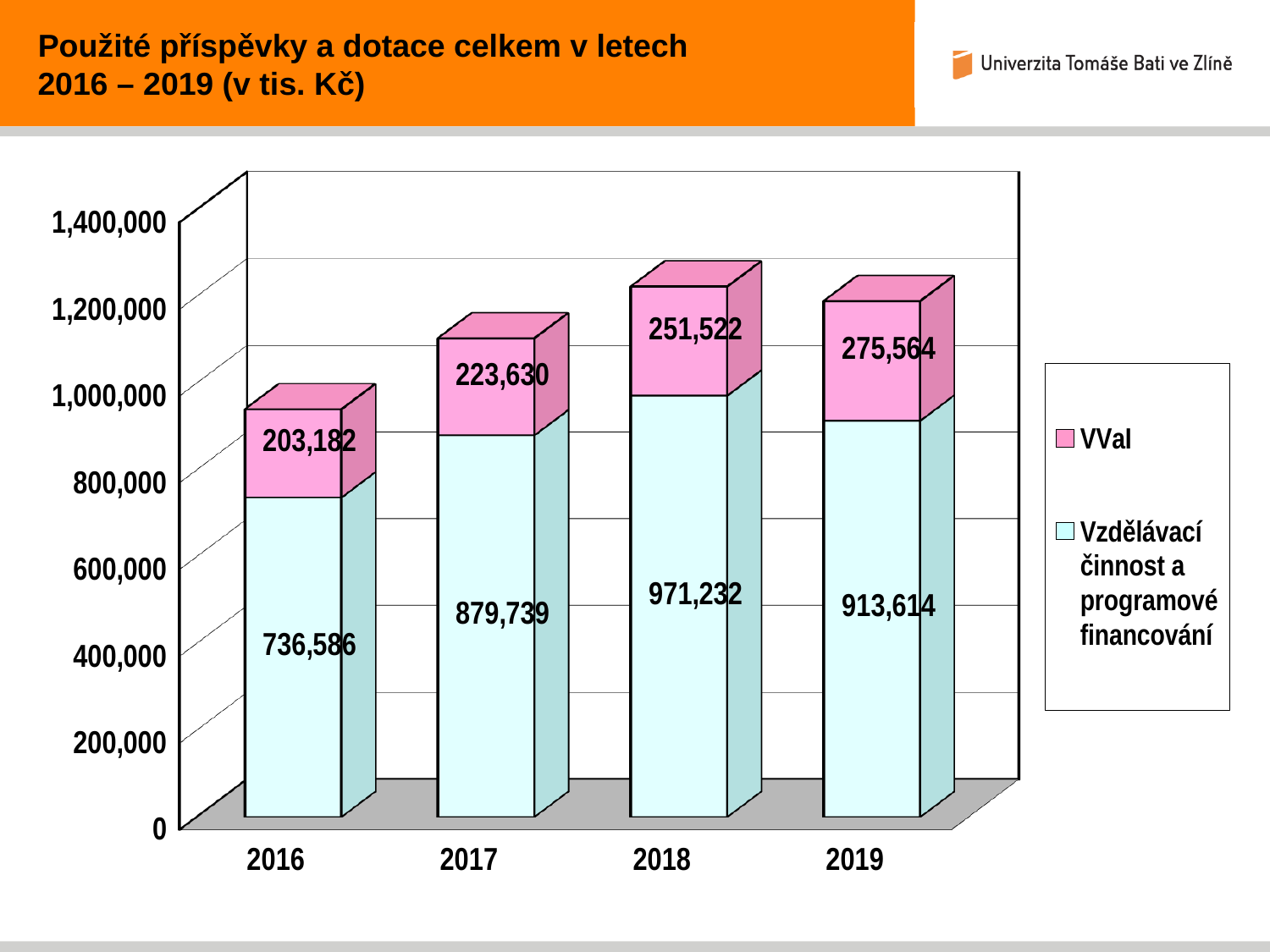
What kind of chart is shown on the slide? Stacked bar chart In which year is the value for VVaI lowest? 2016 How many series does the legend list? 2 What is the total of the stacked bar for 2018? 1,222,754 What is the value for VVaI in 2018? 251,522 How many years are shown on the x axis? 4 Which is larger: the Vzdělávací činnost a programové financování value for 2017 or for 2019? 2019 What is the value for Vzdělávací činnost a programové financování in 2016? 736,586 In which year is the value for Vzdělávací činnost a programové financování highest? 2018 What is the difference between the VVaI values for 2019 and 2016? 72,382 What is the total of the stacked bar for 2016? 939,768 What is the value for VVaI in 2019? 275,564